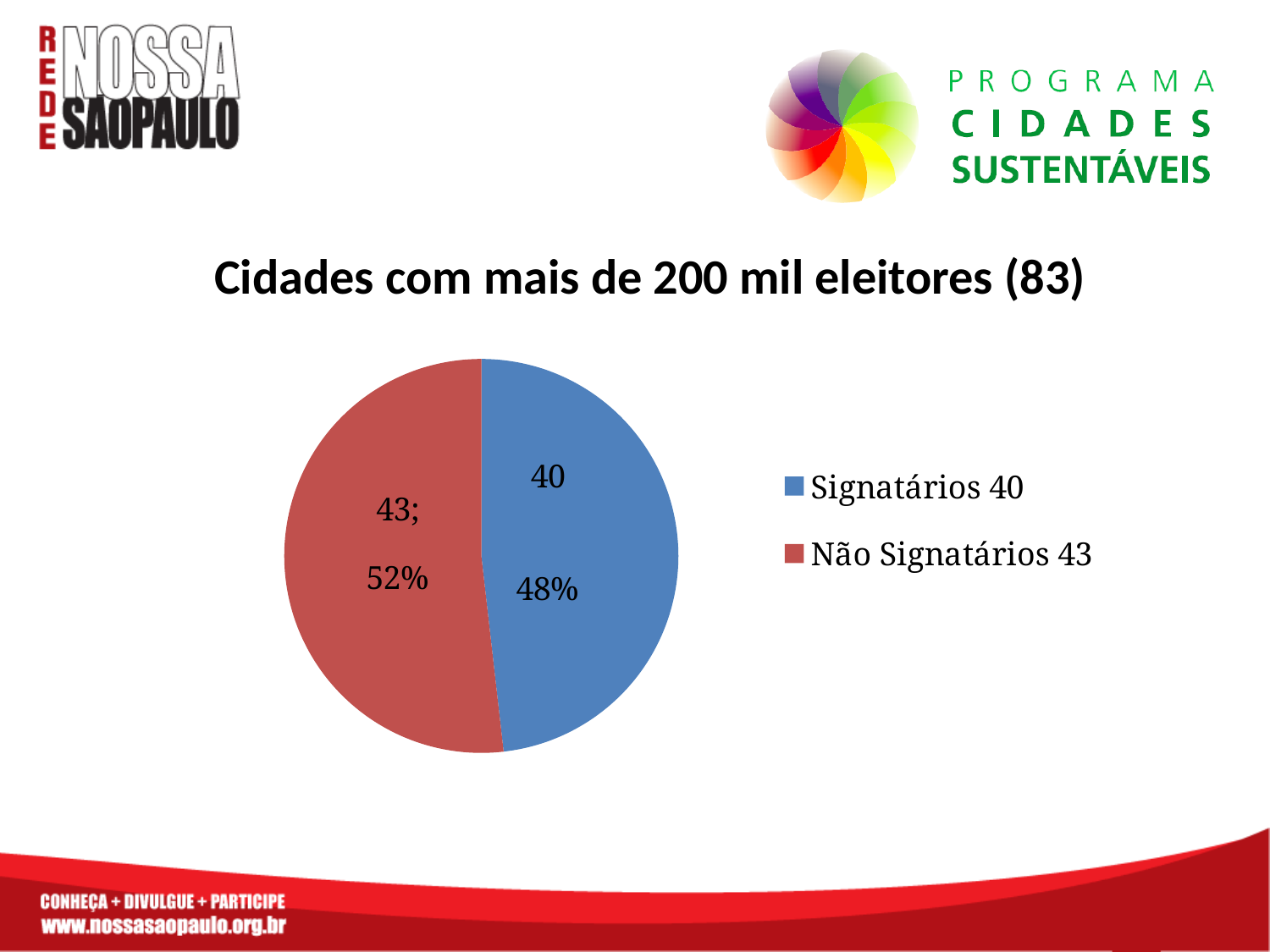
What colour is the Signatários slice? Blue What percentage share does the Não Signatários slice represent? 52% How many slices does the pie chart have? 2 What is the difference between the Não Signatários and Signatários values? 3 What type of chart is shown on the slide? Pie chart What is the value for Signatários? 40 What is the title of the chart? Cidades com mais de 200 mil eleitores (83) What is the total of the two slices in the pie chart? 83 Which category has the smallest slice? Signatários Which category has the larger slice, Signatários or Não Signatários? Não Signatários What percentage share does the Signatários slice represent? 48% What is the value for Não Signatários? 43